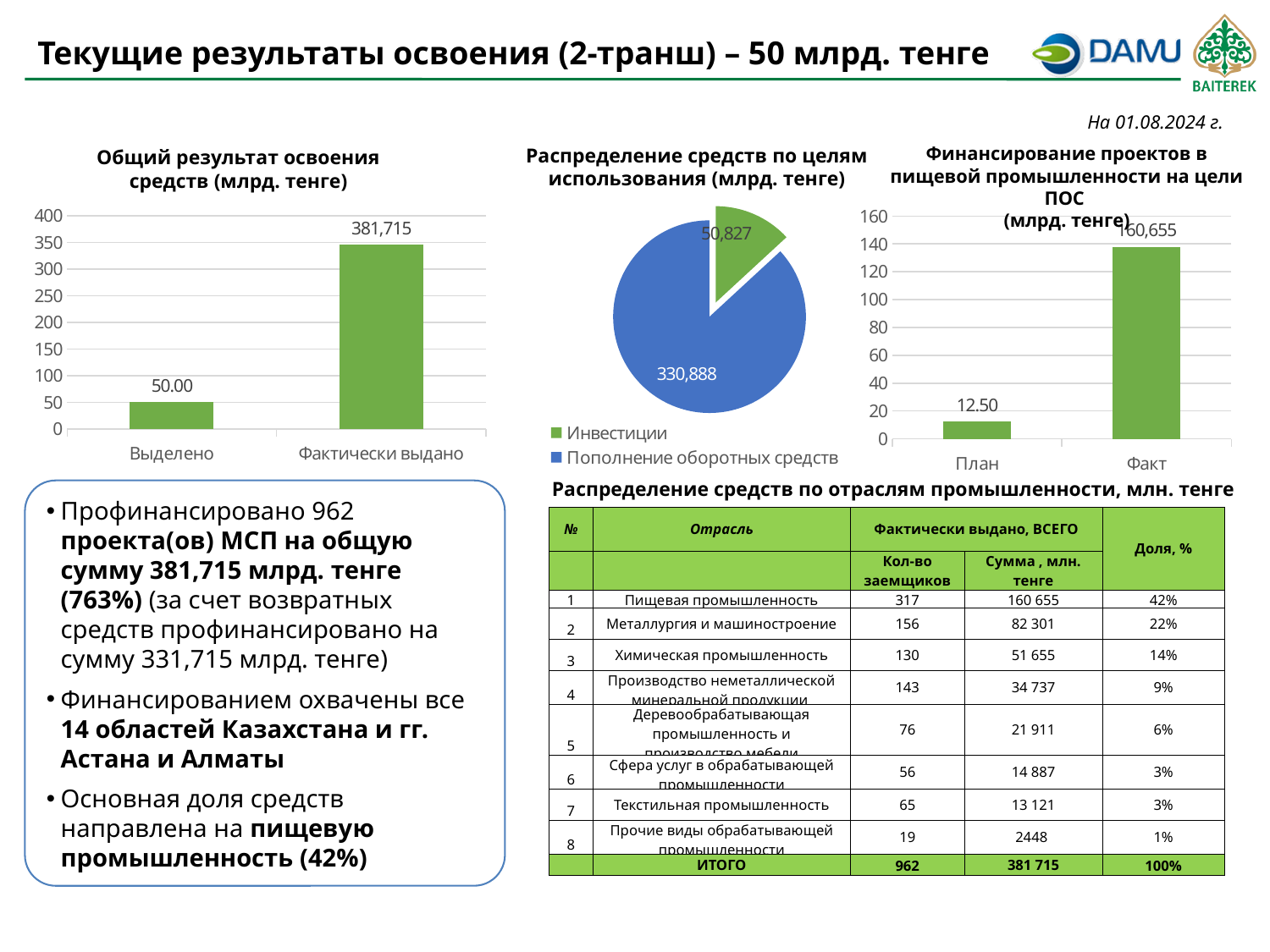
What kind of chart is 'Распределение средств по целям использования (млрд. тенге)'? pie chart In the chart 'Общий результат освоения средств (млрд. тенге)', which category has the higher value? Фактически выдано In the chart 'Общий результат освоения средств (млрд. тенге)', what is the value for 'Выделено'? 50.00 In the chart 'Финансирование проектов в пищевой промышленности на цели ПОС (млрд. тенге)', what is the value for 'Факт'? 160,655 In the chart 'Распределение средств по целям использования (млрд. тенге)', which slice is the largest? Пополнение оборотных средств In the chart 'Финансирование проектов в пищевой промышленности на цели ПОС (млрд. тенге)', what is the value for 'План'? 12.50 What kind of chart is 'Общий результат освоения средств (млрд. тенге)'? bar chart In the chart 'Общий результат освоения средств (млрд. тенге)', what is the value for 'Фактически выдано'? 381,715 In the chart 'Распределение средств по целям использования (млрд. тенге)', what is the value for 'Инвестиции'? 50,827 In the chart 'Распределение средств по целям использования (млрд. тенге)', what is the value for 'Пополнение оборотных средств'? 330,888 How many entries does the legend of the chart 'Распределение средств по целям использования (млрд. тенге)' list? 2